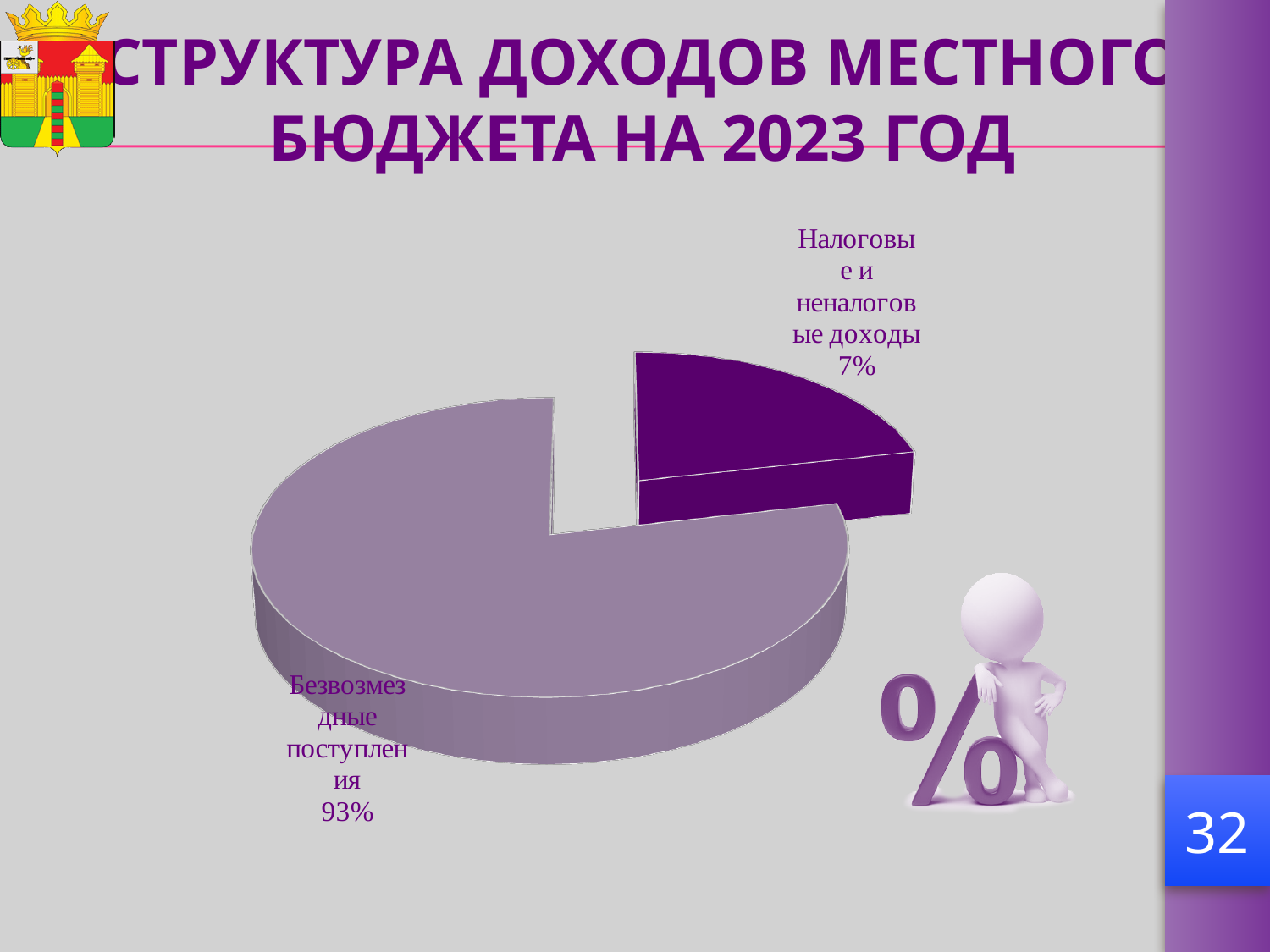
Which slice of the pie is pulled out (exploded) from the rest? Налоговые и неналоговые доходы Which is larger: the share of "Безвозмездные поступления" or the share of "Налоговые и неналоговые доходы"? Безвозмездные поступления What kind of chart is shown on the slide? pie chart Which category has the smallest slice of the pie? Налоговые и неналоговые доходы Which category has the largest slice of the pie? Безвозмездные поступления What is the difference in percentage points between "Безвозмездные поступления" and "Налоговые и неналоговые доходы"? 86 What share of the pie does "Налоговые и неналоговые доходы" have? 7% What is the title of the slide containing the pie chart? СТРУКТУРА ДОХОДОВ МЕСТНОГО БЮДЖЕТА НА 2023 ГОД What share of the pie does "Безвозмездные поступления" have? 93% How many slices does the pie chart have? 2